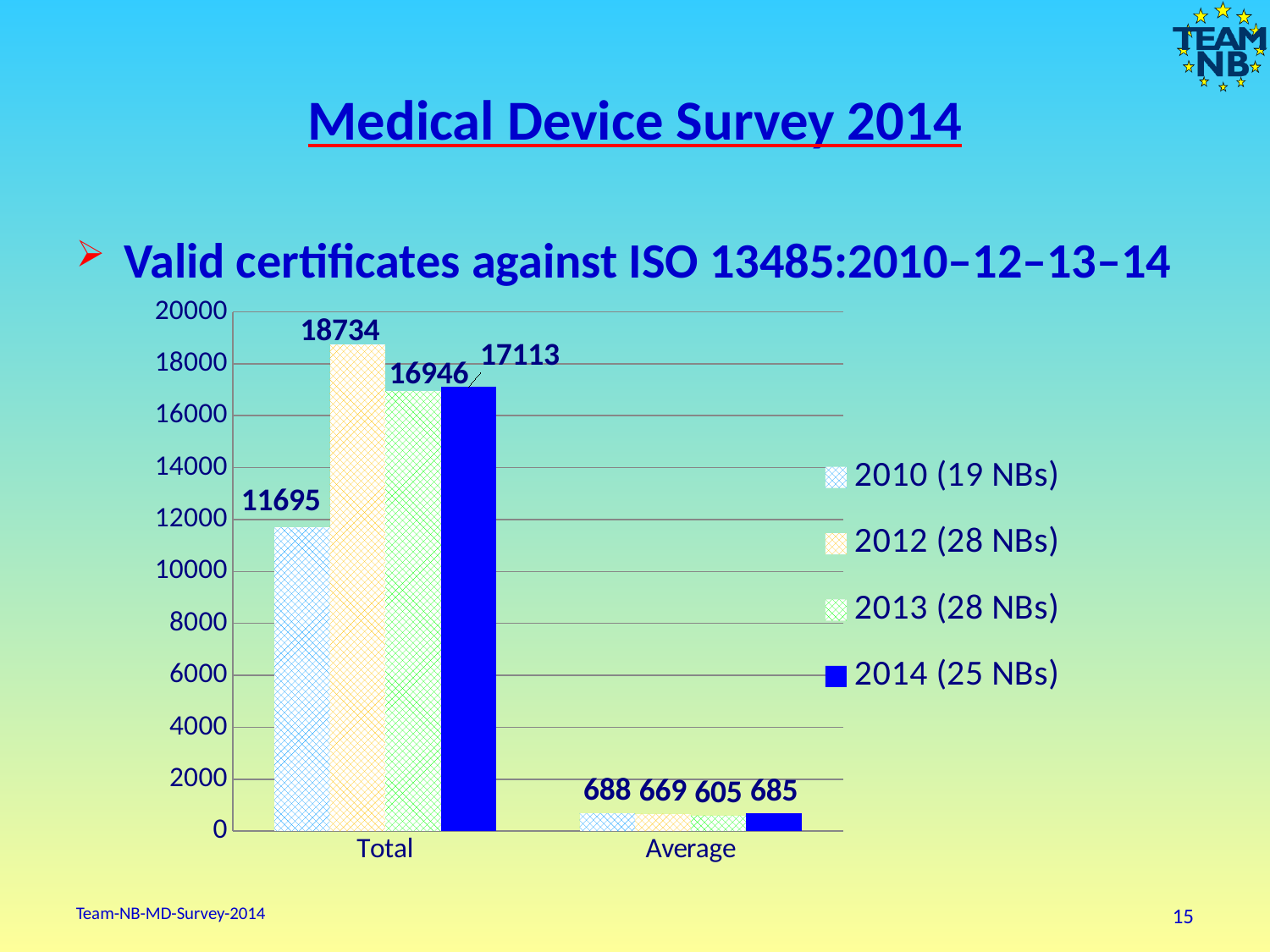
What is the Total value for the 2010 (19 NBs) series? 11695 Which is larger, the Average value for 2010 (19 NBs) or for 2012 (28 NBs)? 2010 (19 NBs) What is the Total value for the 2012 (28 NBs) series? 18734 How many series does the legend list? 4 Which series has the highest Total value? 2012 (28 NBs) How many categories are shown on the x axis? 2 What kind of chart is shown on the slide? bar chart Which series is shown as a solid blue bar in the legend? 2014 (25 NBs) Is the Total value for 2010 (19 NBs) greater or less than 12000? less Which series has the lowest Average value? 2013 (28 NBs) What is the Average value for the 2014 (25 NBs) series? 685 What is the difference between the Total values for 2014 (25 NBs) and 2013 (28 NBs)? 167